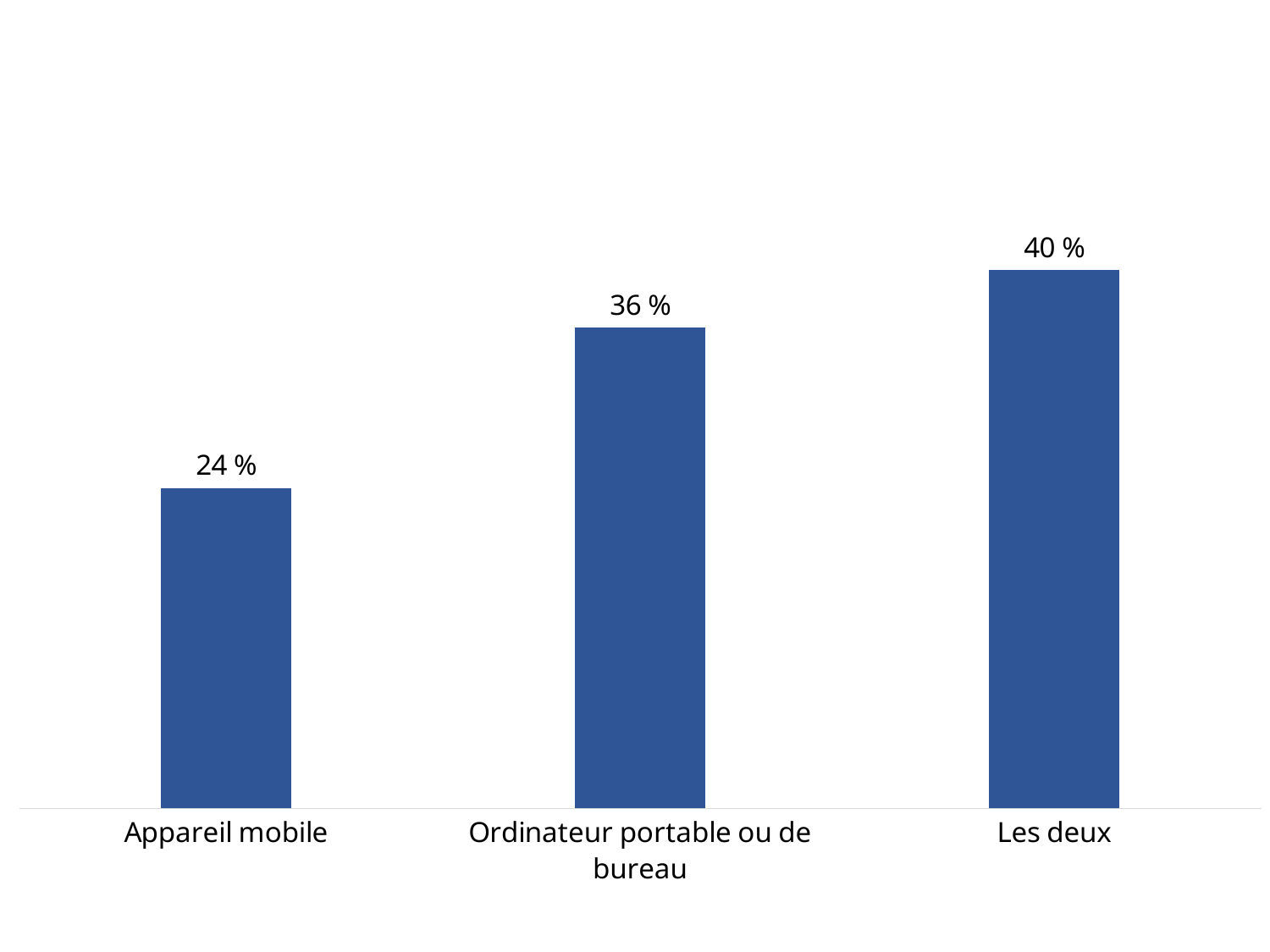
What is the value for Les deux? 40 % What is the difference between the values for Ordinateur portable ou de bureau and Appareil mobile? 12 % What is the value for Appareil mobile? 24 % What is the difference between the values for Les deux and Appareil mobile? 16 % What kind of chart is shown on the slide? Bar chart Which is larger, the value for Ordinateur portable ou de bureau or the value for Les deux? Les deux Which category has the highest value? Les deux Do the values rise or fall from left to right across the categories? Rise Which category has the lowest value? Appareil mobile How many categories are shown in the chart? 3 Which is larger, the value for Appareil mobile or the value for Ordinateur portable ou de bureau? Ordinateur portable ou de bureau What is the value for Ordinateur portable ou de bureau? 36 %